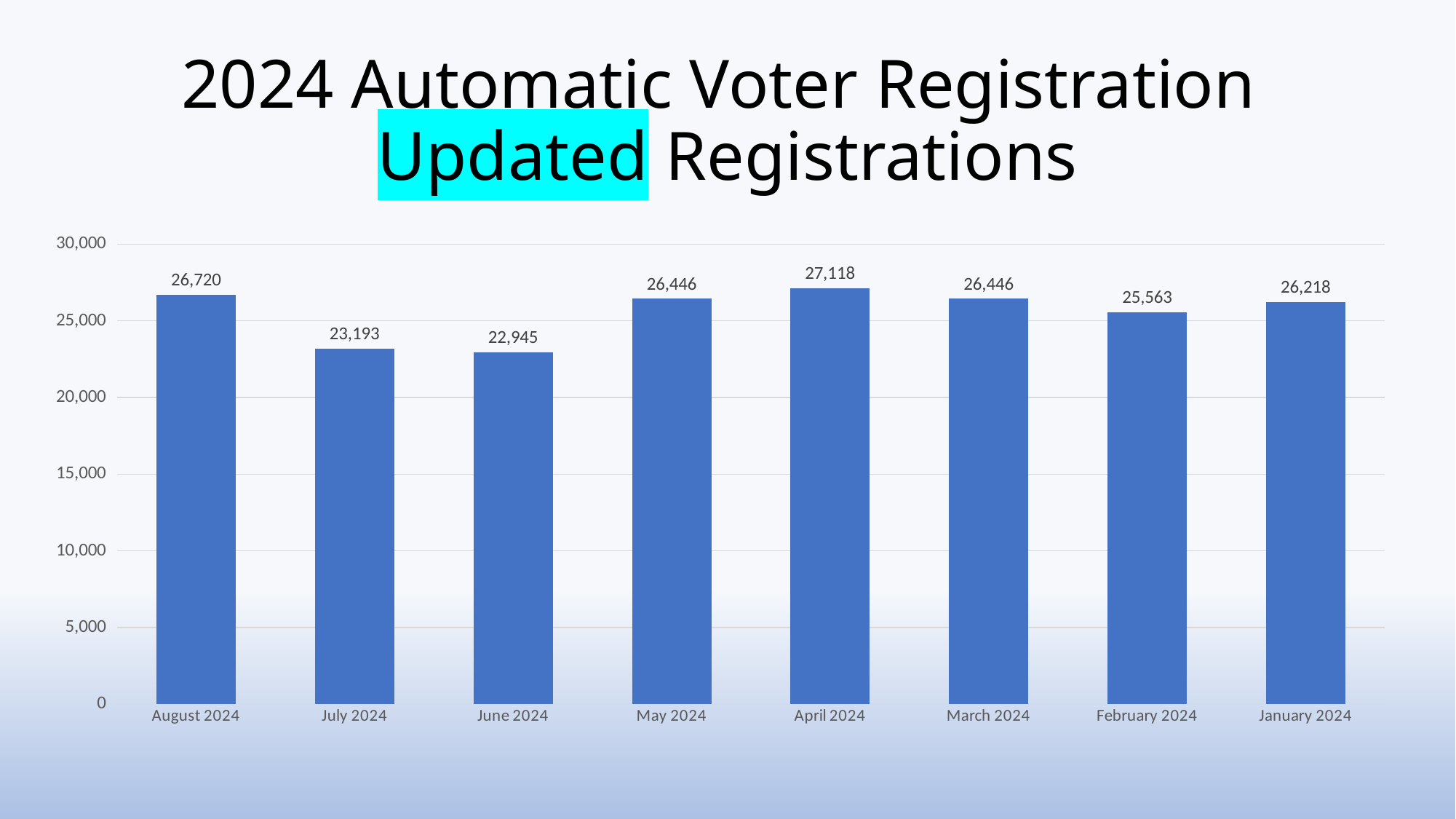
Which month has the highest value? April 2024 How many months are shown on the chart? 8 Is the value for July 2024 greater or less than 25,000? less Which month has the lowest value? June 2024 What is the value for August 2024? 26,720 What is the value for June 2024? 22,945 What is the title of the slide? 2024 Automatic Voter Registration Updated Registrations What kind of chart is shown on the slide? bar chart What is the value for February 2024? 25,563 What is the difference between the values for August 2024 and July 2024? 3,527 Which is larger, the value for January 2024 or the value for February 2024? January 2024 What is the difference between the values for April 2024 and June 2024? 4,173